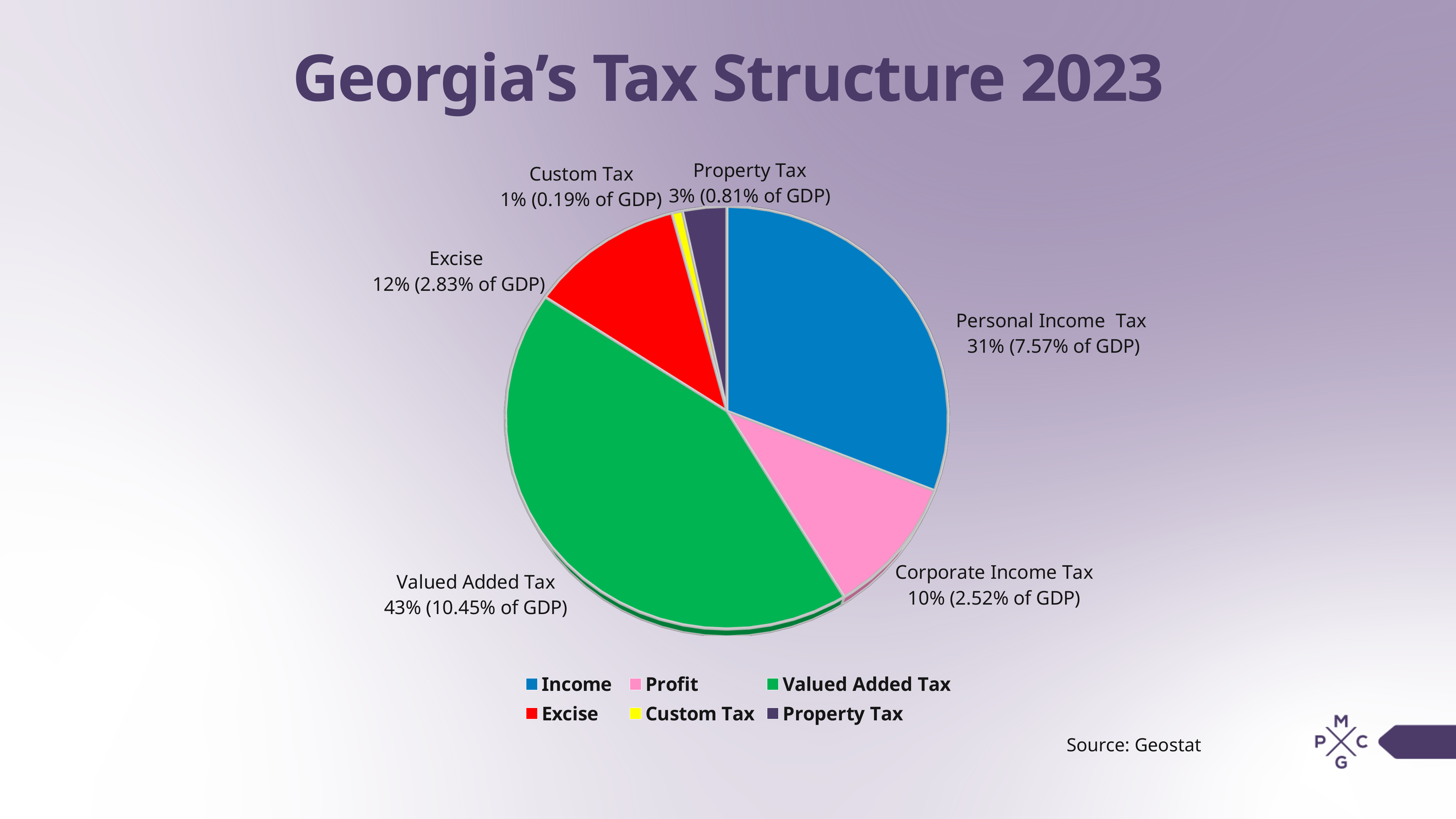
What is the GDP percentage shown for Excise? 2.83% of GDP What kind of chart is shown on the slide? Pie chart Which slice of the pie is the largest? Valued Added Tax Which has a larger share, Excise or Corporate Income Tax? Excise What colour is the Property Tax slice? Dark purple How many slices does the pie chart have? 6 What is the GDP percentage shown for Corporate Income Tax? 2.52% of GDP What share of the pie does Valued Added Tax represent? 43% Which slice of the pie is the smallest? Custom Tax What is the difference in share between Valued Added Tax and Personal Income Tax? 12% What share of the pie does Personal Income Tax represent? 31% What is the title of the chart? Georgia's Tax Structure 2023